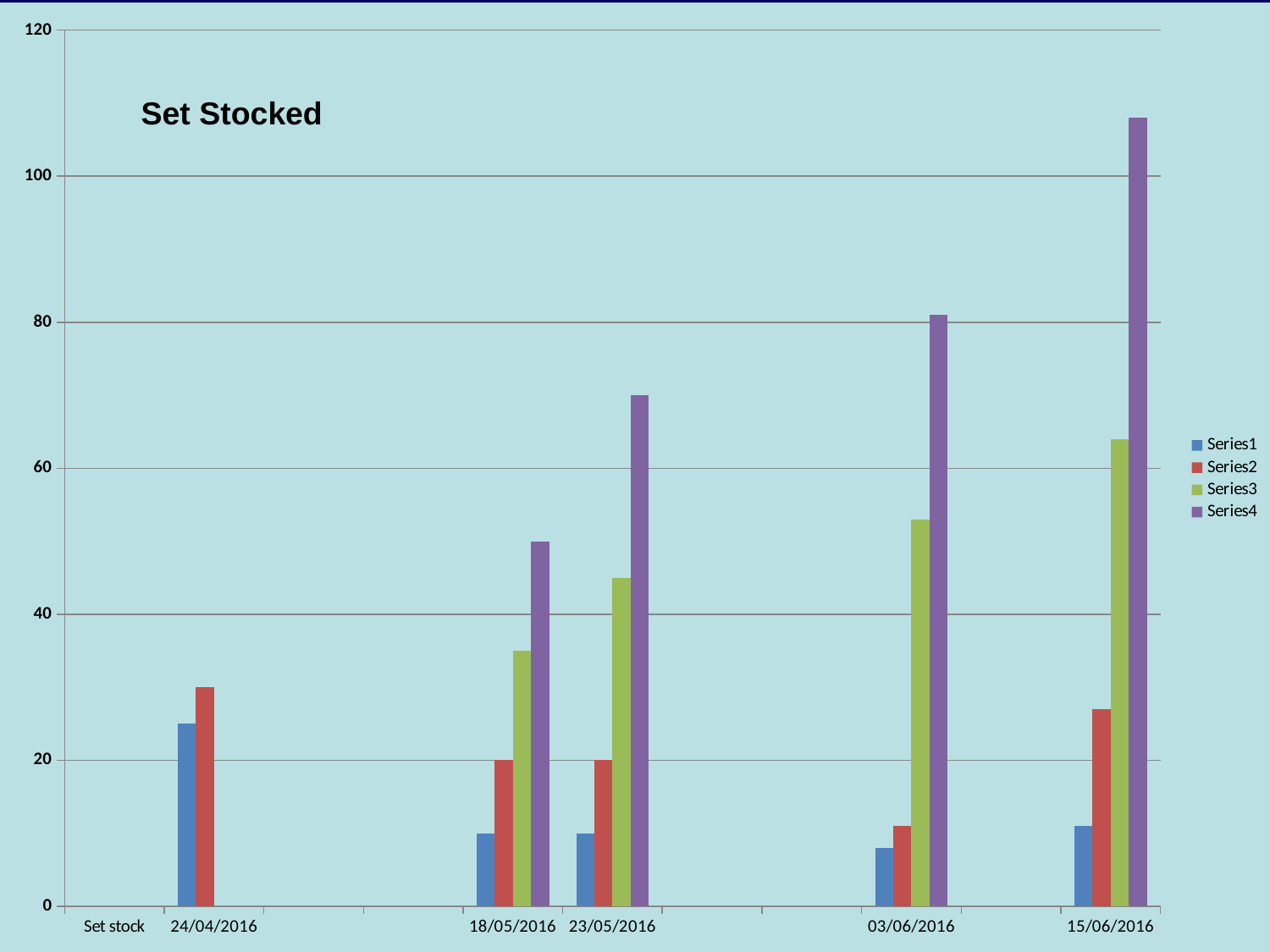
Which is larger on 23/05/2016, Series3 or Series4? Series4 Which series is shown in purple in the legend? Series4 Does the Series4 value rise or fall from 18/05/2016 to 15/06/2016? rise How many dates are labelled on the x axis? 5 What is the title of the chart? Set Stocked Which date has the highest Series4 bar? 15/06/2016 Is the value for Series4 on 15/06/2016 greater or less than 100? greater What kind of chart is shown on the slide? bar chart How many series does the legend list? 4 Is the value for Series3 on 18/05/2016 greater or less than 40? less Is the value for Series1 on 24/04/2016 greater or less than 20? greater